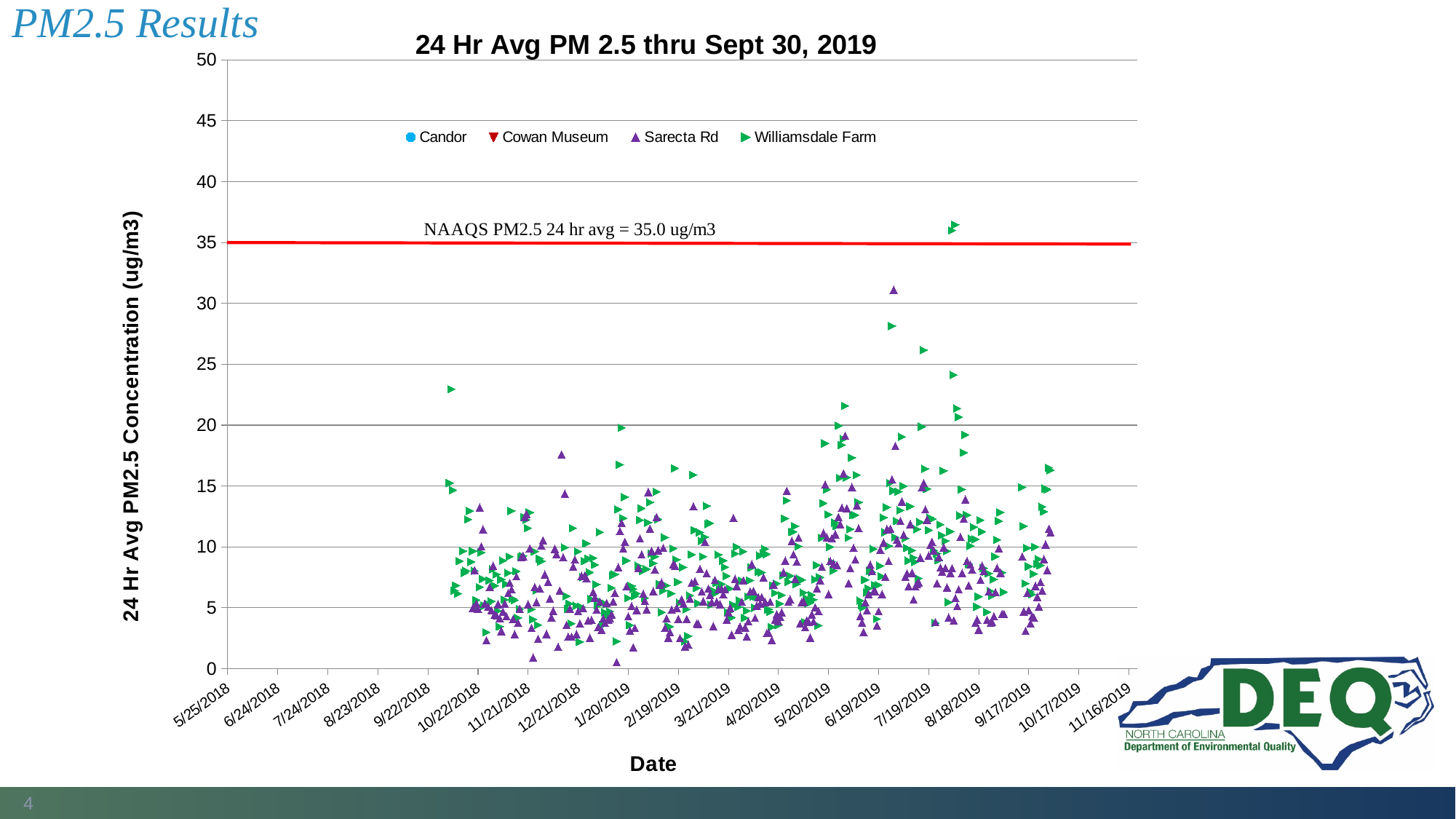
Is the highest plotted value for Sarecta Rd greater or less than 25? greater Which series is plotted with green markers? Williamsdale Farm Which series has the highest plotted value on the chart? Williamsdale Farm Is the highest plotted value for Sarecta Rd greater or less than 35? less Which series has the higher maximum plotted value, Sarecta Rd or Williamsdale Farm? Williamsdale Farm Is the highest plotted value for Williamsdale Farm greater or less than 35? greater What is the title of the chart? 24 Hr Avg PM 2.5 thru Sept 30, 2019 What kind of chart is shown on the slide? Scatter chart What is the maximum value shown on the y axis? 50 What value does the red NAAQS PM2.5 24 hr avg line represent? 35.0 ug/m3 How many series does the chart legend list? 4